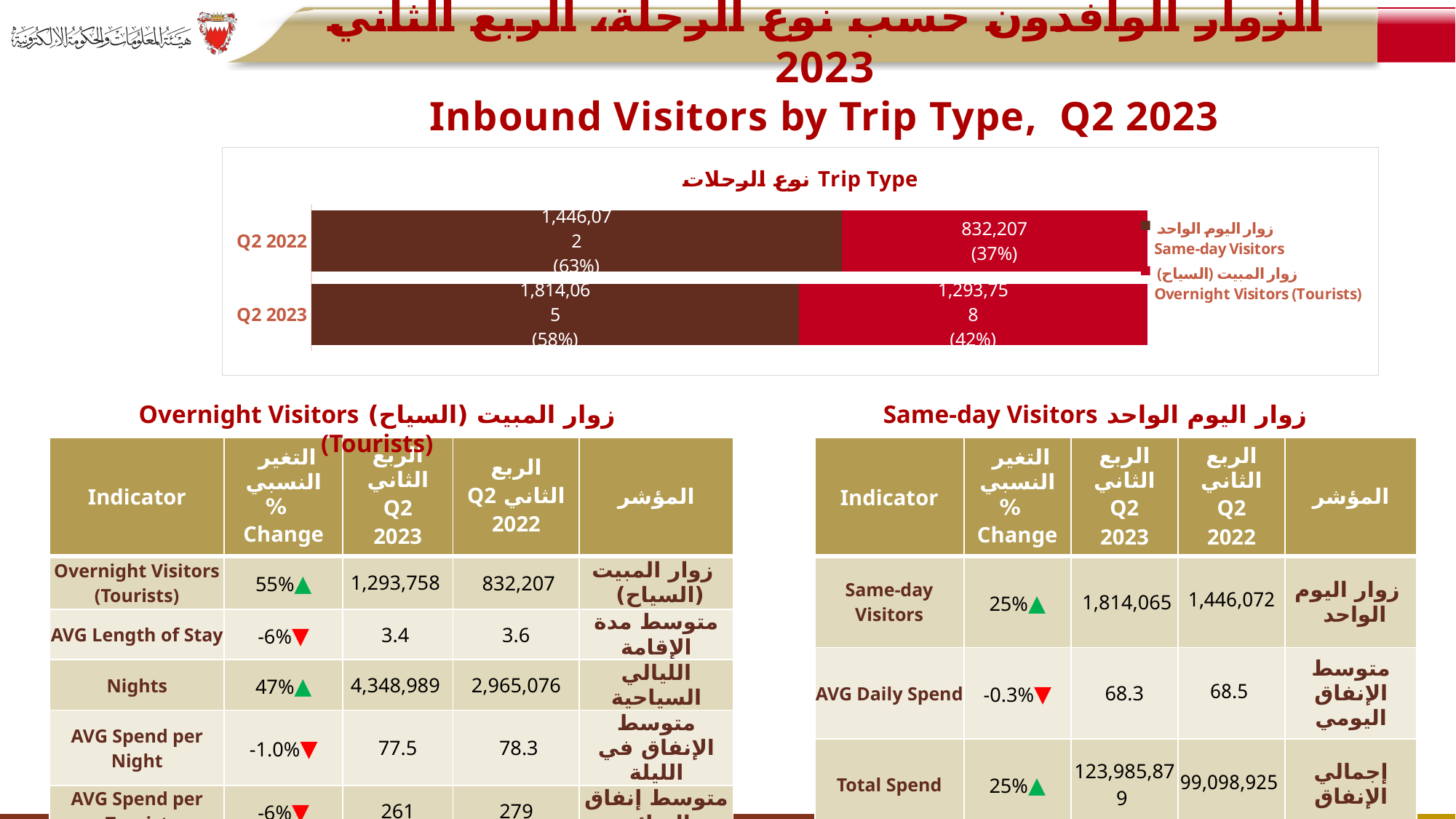
In the Trip Type chart, by how much did Overnight Visitors (Tourists) increase from Q2 2022 to Q2 2023? 461,551 In the Trip Type chart, what is the total number of inbound visitors in Q2 2022? 2,278,279 In the Trip Type chart, how many periods (categories) are plotted? 2 In the Trip Type chart, what percentage share do Overnight Visitors (Tourists) have in Q2 2023? 42% In the Trip Type chart, what percentage share do Same-day Visitors have in Q2 2022? 63% What type of chart is the Trip Type chart? Stacked bar chart In the Trip Type chart, which colour represents Overnight Visitors (Tourists)? Red In the Trip Type chart, what is the total number of inbound visitors in Q2 2023? 3,107,823 In the Trip Type chart, which is larger in Q2 2023: Same-day Visitors or Overnight Visitors (Tourists)? Same-day Visitors In the Trip Type chart, what is the number of Overnight Visitors (Tourists) in Q2 2022? 832,207 In the Trip Type chart, what is the number of Same-day Visitors in Q2 2023? 1,814,065 In the Trip Type chart, how many series does the legend list? 2